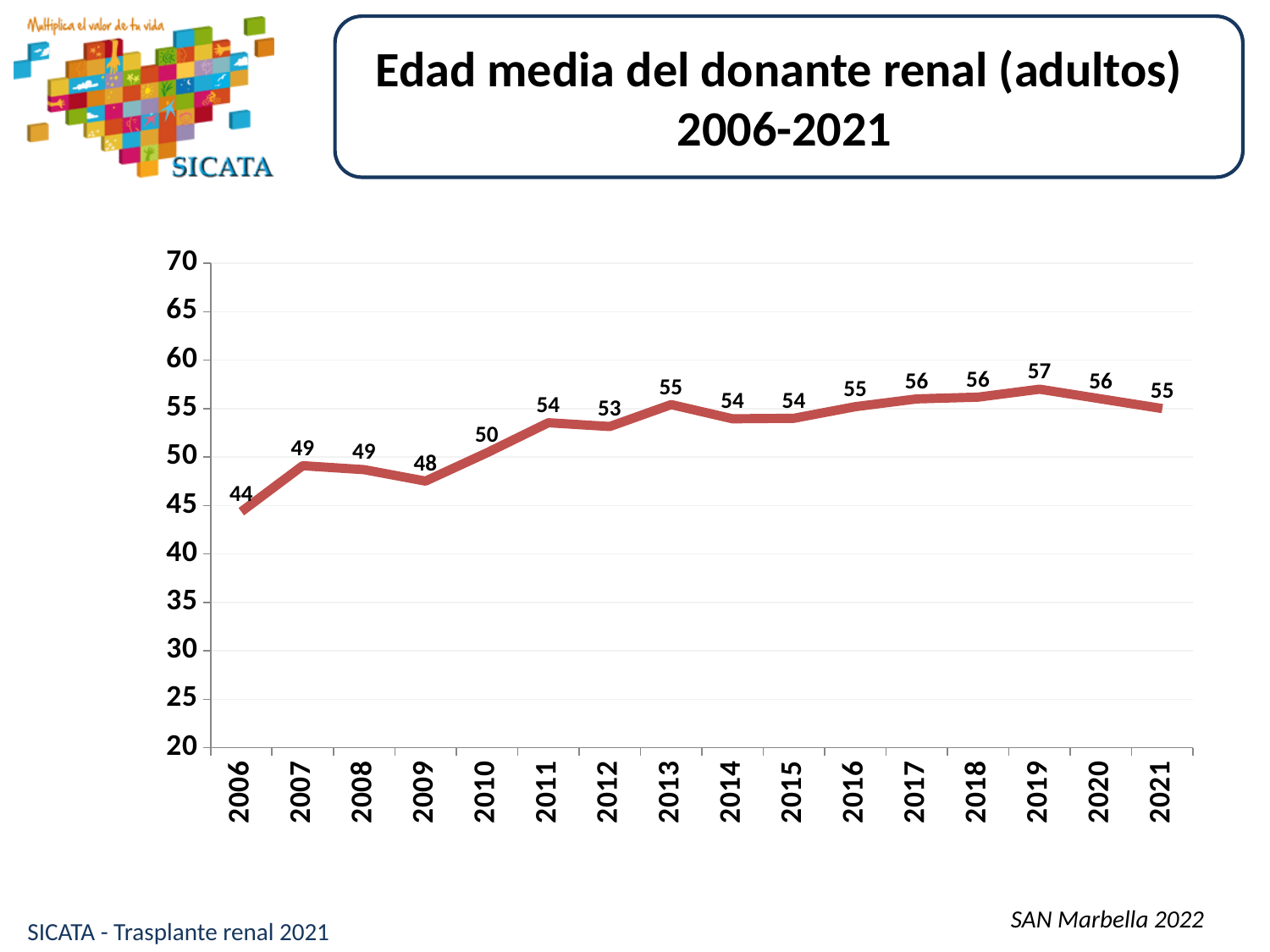
What is the difference between the values for 2019 and 2006? 13 What kind of chart is shown on the slide? line chart What is the mean kidney donor age shown for 2006? 44 Is the value for 2006 greater or less than 45? less What is the value plotted for 2010? 50 Which is larger, the value for 2009 or the value for 2013? 2013 Which year has the highest mean donor age? 2019 What is the value plotted for 2019? 57 Which year has the lowest mean donor age? 2006 What is the value plotted for 2021? 55 Overall, do the values rise or fall from 2006 to 2021? rise How many years are plotted on the x axis? 16